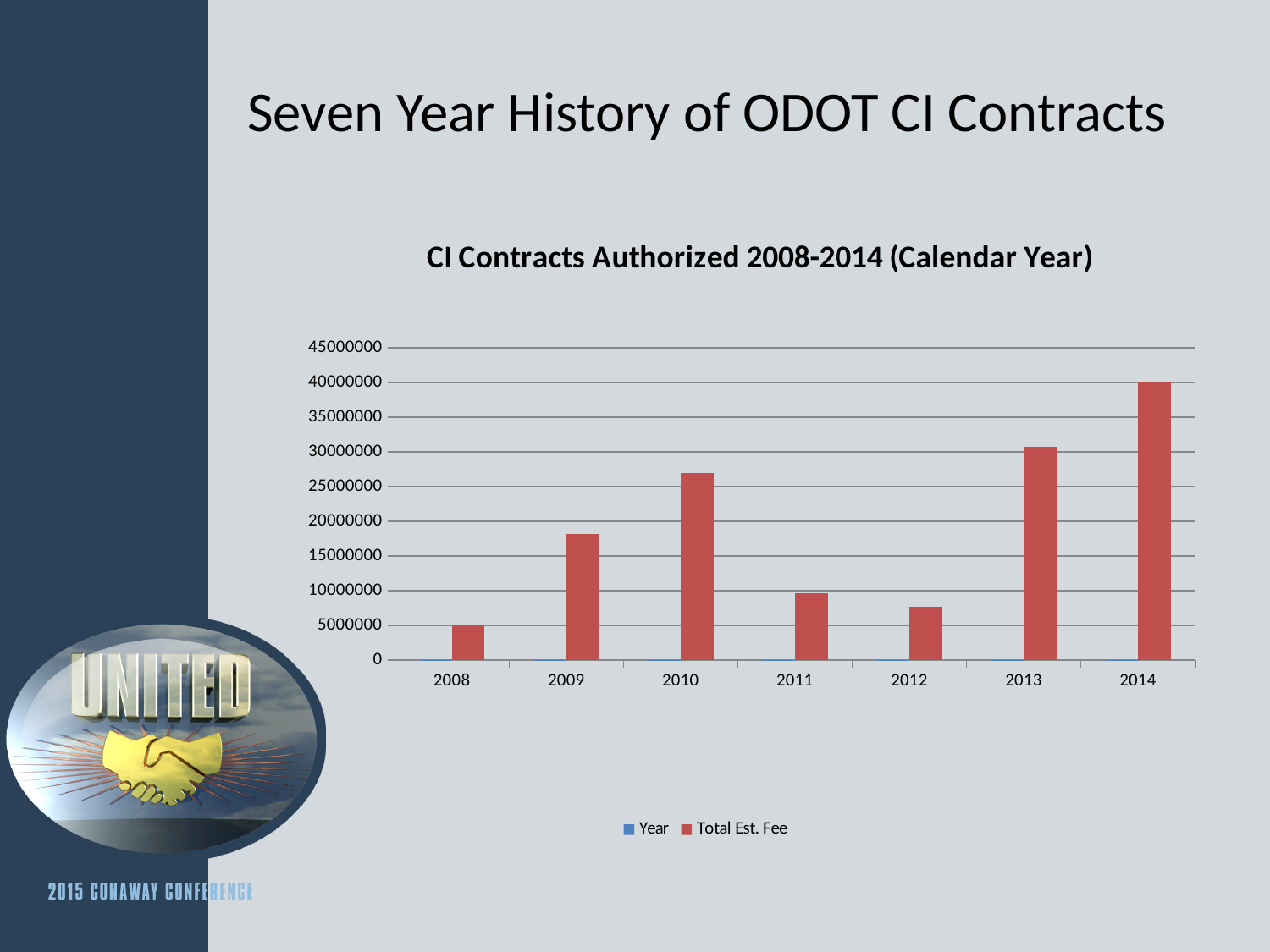
What kind of chart is shown on the slide? bar chart Which year has the highest Total Est. Fee? 2014 How many years are shown along the x axis of the chart? 7 Which year has the lowest Total Est. Fee? 2008 What are the two entries listed in the chart's legend? Year and Total Est. Fee Which year has a larger Total Est. Fee, 2009 or 2011? 2009 Is the Total Est. Fee for 2012 greater or less than 10000000? less Is the Total Est. Fee for 2010 greater or less than 25000000? greater Which year has a larger Total Est. Fee, 2010 or 2013? 2013 How many series does the chart's legend list? 2 What is the title of the chart? CI Contracts Authorized 2008-2014 (Calendar Year)